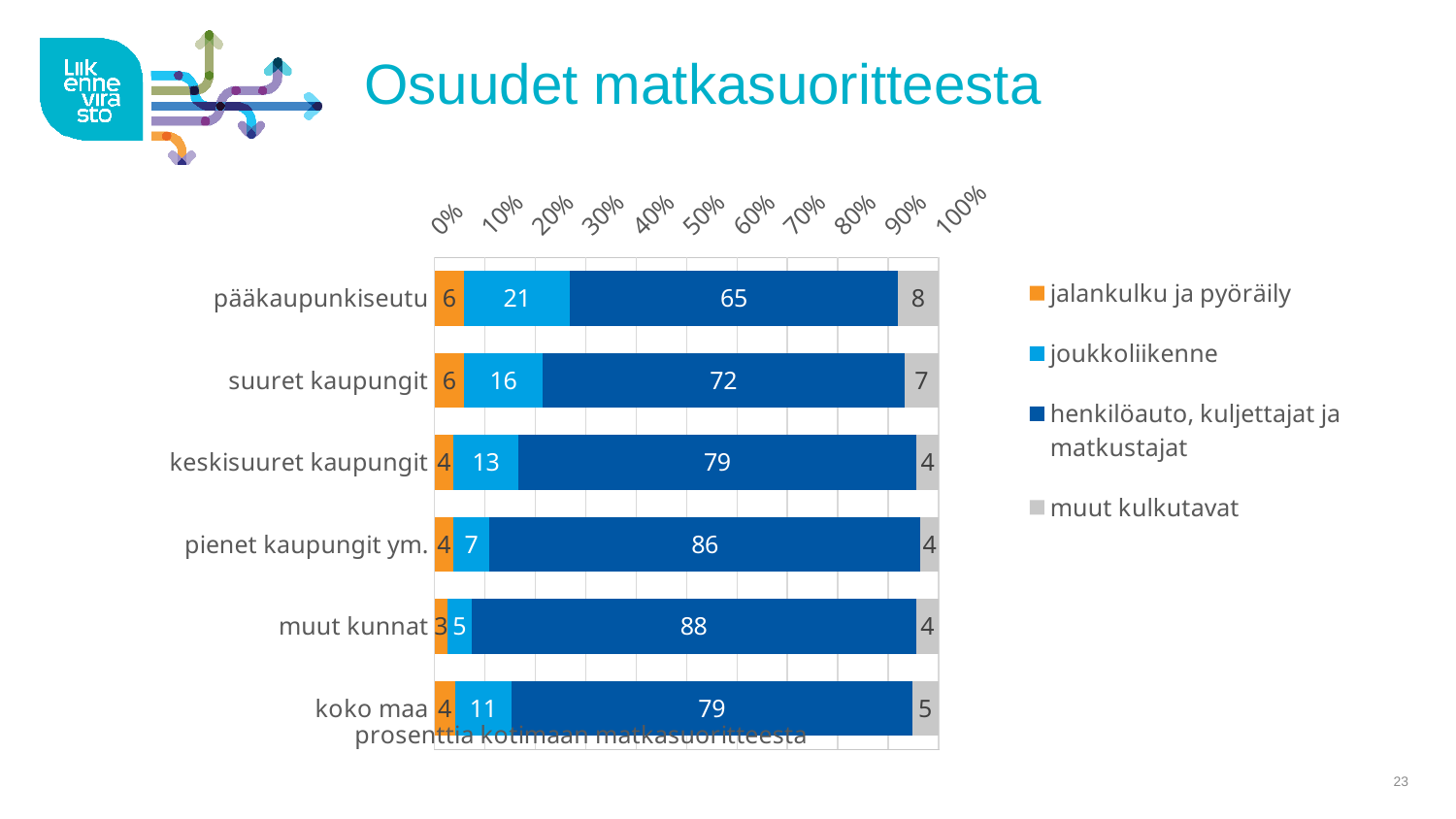
What is the joukkoliikenne value for suuret kaupungit? 16 How many series does the legend list? 4 What is the jalankulku ja pyöräily value for muut kunnat? 3 How many categories are shown on the y axis of the chart? 6 Which category has the lowest joukkoliikenne value? muut kunnat What is the total of the stacked bar for pääkaupunkiseutu? 100 Which is larger: the henkilöauto, kuljettajat ja matkustajat value for pienet kaupungit ym. or for keskisuuret kaupungit? pienet kaupungit ym. What kind of chart is shown on the slide? stacked bar chart What is the value for henkilöauto, kuljettajat ja matkustajat in pääkaupunkiseutu? 65 Which category has the highest henkilöauto, kuljettajat ja matkustajat value? muut kunnat What is the muut kulkutavat value for koko maa? 5 What is the difference between the joukkoliikenne values for pääkaupunkiseutu and koko maa? 10